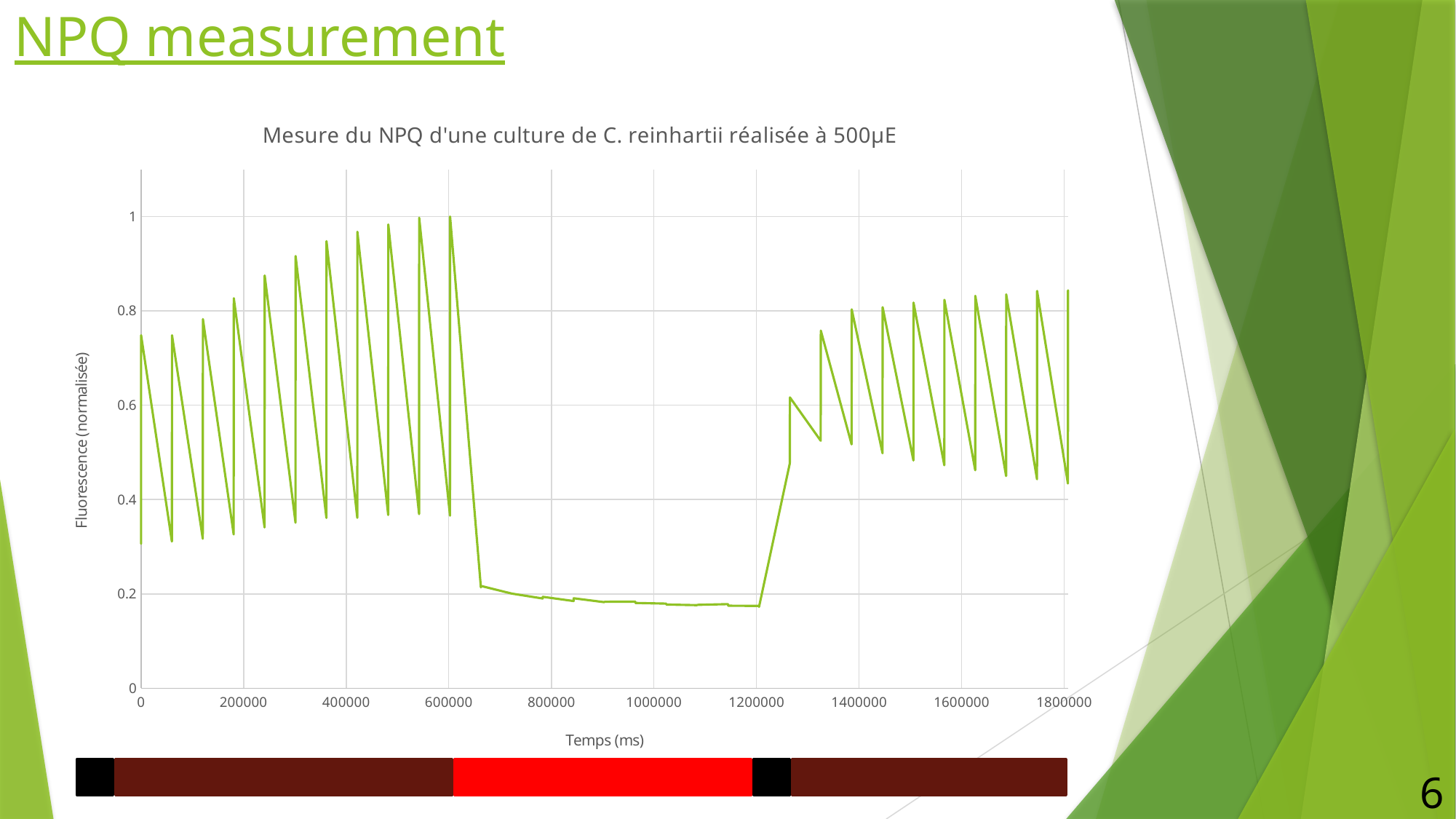
Do the peaks of the fluorescence curve between 0 and 600000 ms rise or fall over time? rise What kind of chart is shown on the slide? line chart What is the maximum value shown on the y axis? 1 Between 700000 ms and 1200000 ms, does the fluorescence curve rise, fall, or stay roughly flat? stay roughly flat Is the fluorescence value at 1000000 ms greater or less than 0.4? less Is the fluorescence value at 800000 ms greater or less than 0.6? less Is the highest peak of the fluorescence curve greater or less than 0.8? greater How many data series are plotted on the chart? 1 What is the label of the x axis? Temps (ms) Which is larger: the fluorescence value at 1000000 ms or the peak value near 600000 ms? the peak value near 600000 ms What is the title of the chart? Mesure du NPQ d'une culture de C. reinhartii réalisée à 500µE